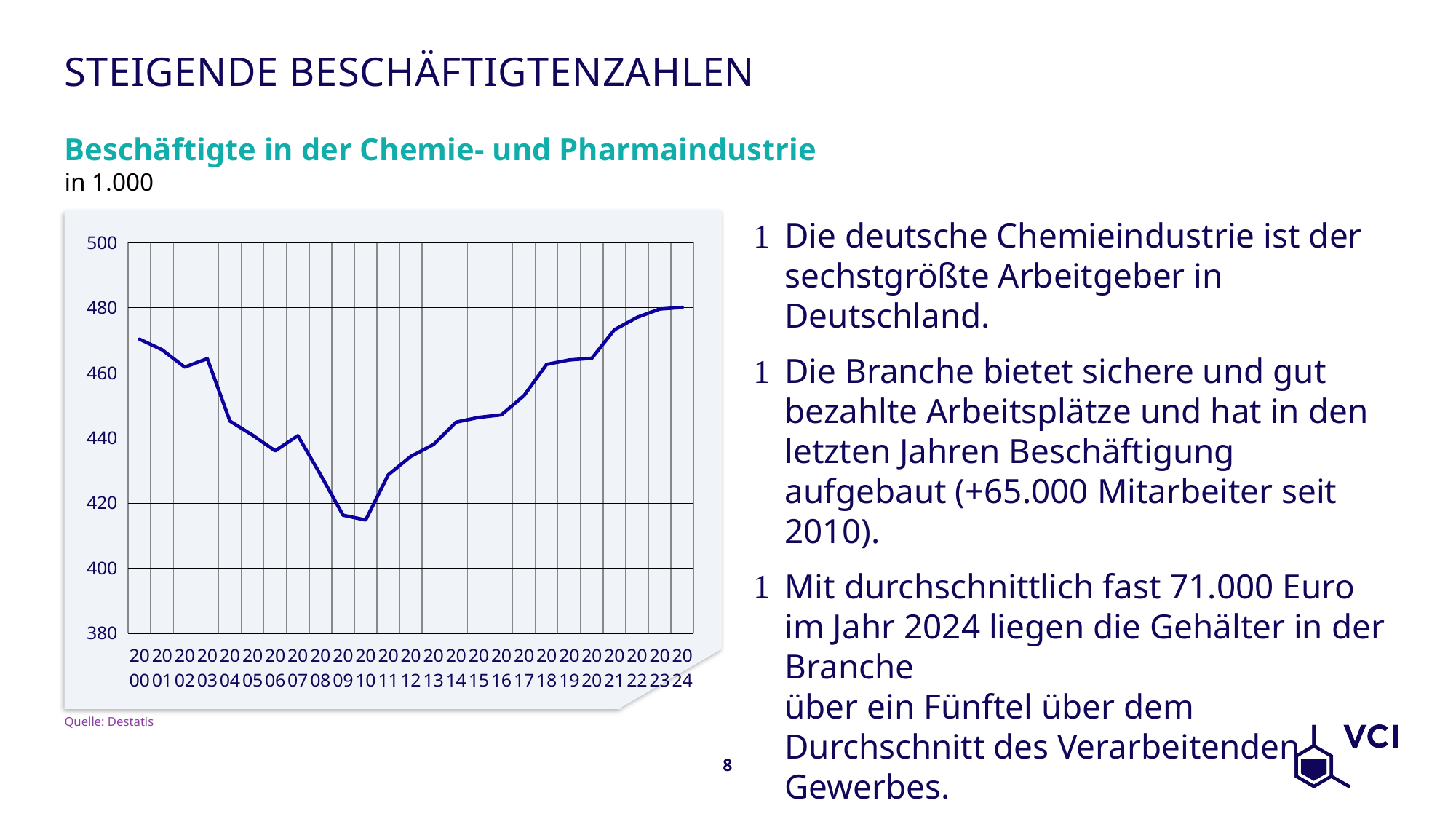
Is the value for 2010 greater or less than 420? less In what unit are the values on the chart given? in 1.000 Is the value for 2024 greater or less than 460? greater Is the value for 2014 greater or less than 440? greater How many years are plotted on the x axis of the chart? 25 What kind of chart is shown on the slide? line chart Which year has the larger value, 2024 or 2009? 2024 Do the values rise or fall from 2010 to 2024? rise Which year has the larger value, 2000 or 2010? 2000 What is the title of the chart? Beschäftigte in der Chemie- und Pharmaindustrie